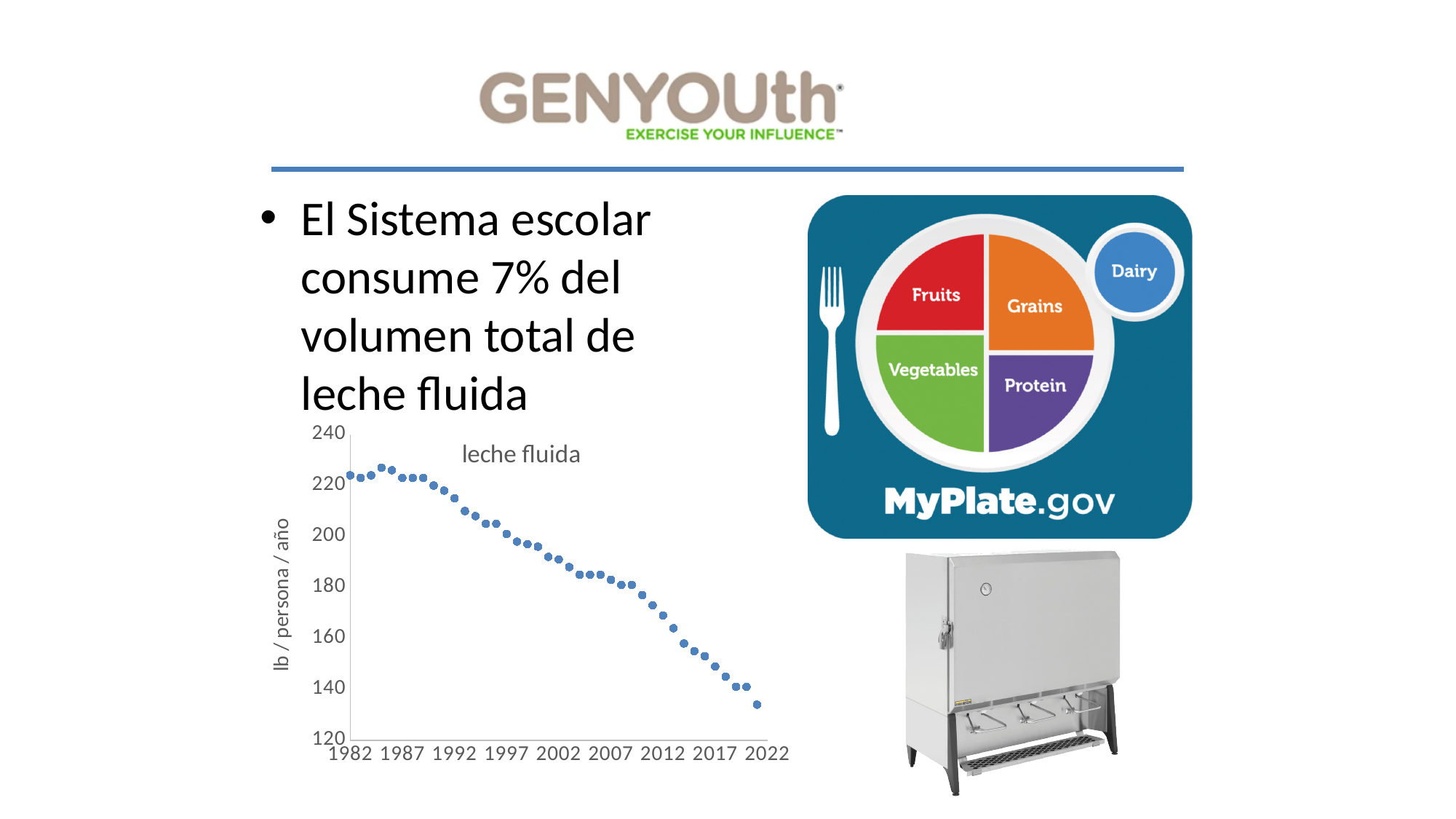
What is the title of the chart on the slide? leche fluida In the 'leche fluida' chart, is the value for 2012 greater or less than 180? less What is the y-axis label of the 'leche fluida' chart? lb / persona / año In the 'leche fluida' chart, is the value for 1982 greater or less than 200? greater In the 'leche fluida' chart, is the value for 2002 greater or less than 200? less Do the values in the 'leche fluida' chart rise or fall from 1982 to 2022? fall In the 'leche fluida' chart, is the lowest value at the beginning or the end of the series? end In the 'leche fluida' chart, which year has the larger value, 1982 or 2017? 1982 What kind of chart is the 'leche fluida' chart? scatter chart